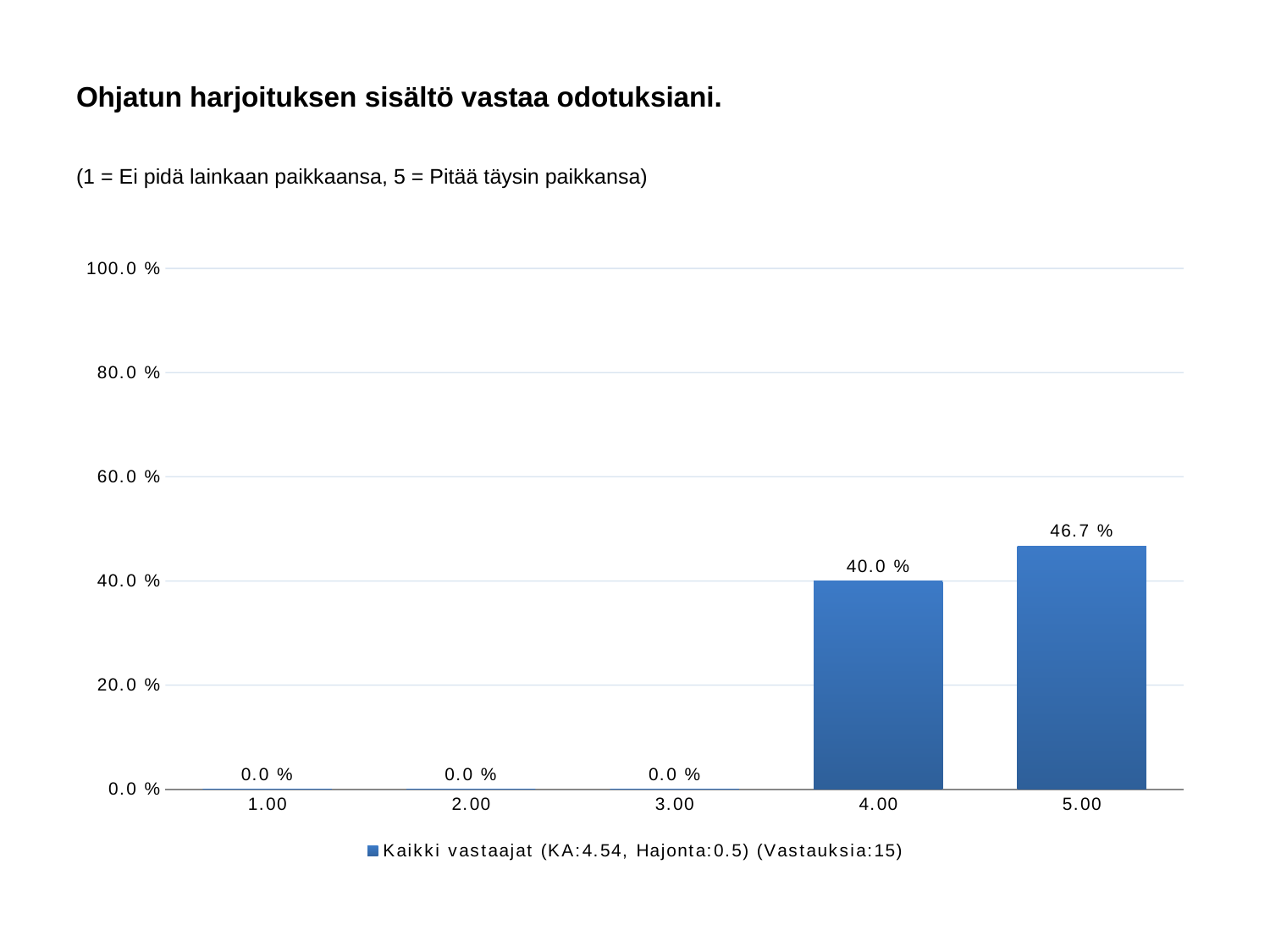
What is the difference between the values for 5.00 and 4.00? 6.7 % How many categories are shown on the x axis? 5 Is the value for 5.00 greater or less than 60.0 %? less How many series does the legend list? 1 How many categories have a value of 0.0 %? 3 What is the value for category 5.00? 46.7 % Which is larger, the value for 4.00 or the value for 5.00? 5.00 What kind of chart is shown? bar chart Which category has the highest value? 5.00 What is the title of the chart? Ohjatun harjoituksen sisältö vastaa odotuksiani. What is the value for category 1.00? 0.0 % What is the value for category 4.00? 40.0 %